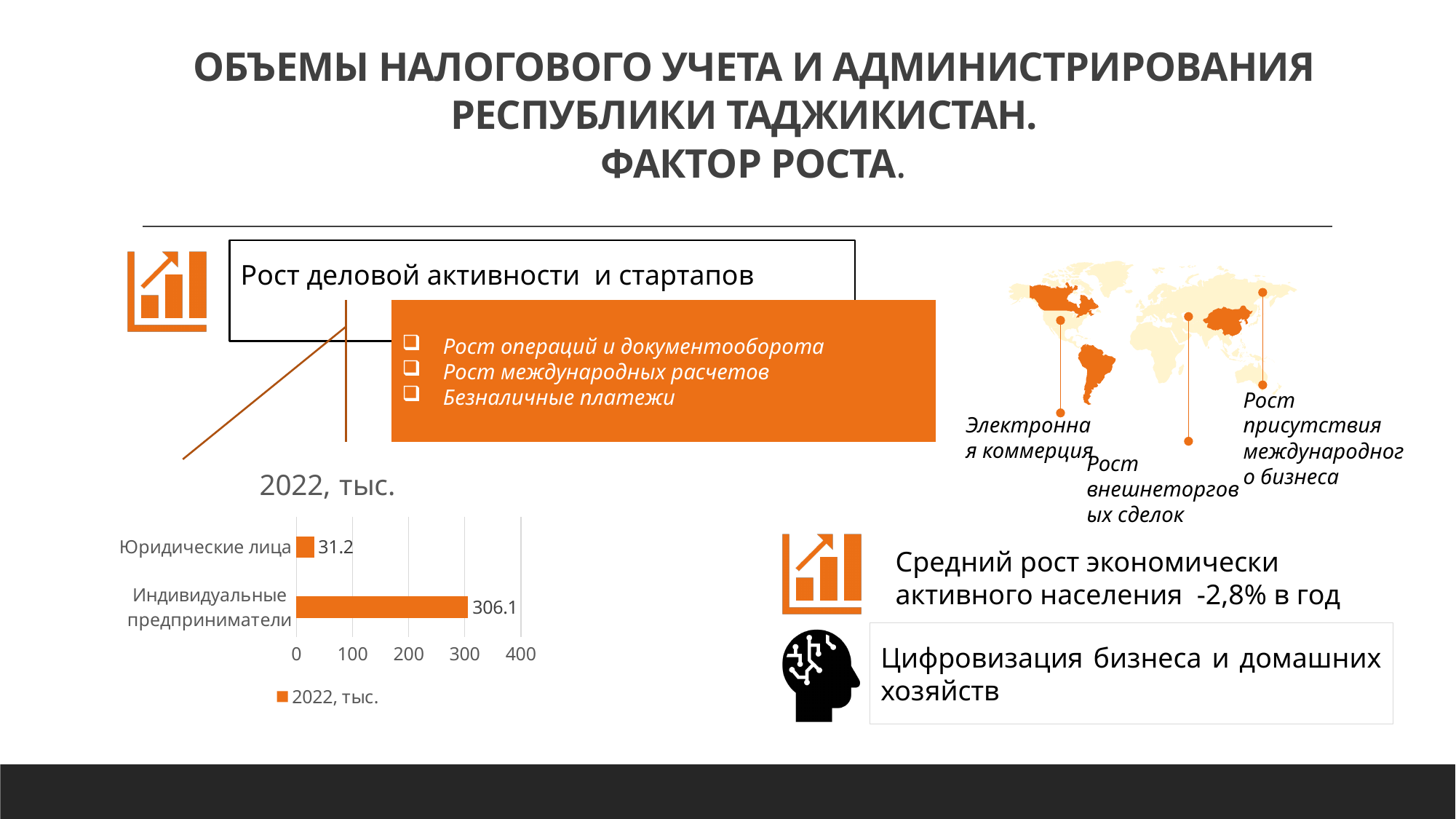
How many categories are shown in the chart titled 2022, тыс.? 2 How many series does the legend list in the chart titled 2022, тыс.? 1 What is the value for Индивидуальные предприниматели in the chart titled 2022, тыс.? 306.1 What is the difference between the values for Индивидуальные предприниматели and Юридические лица in the chart titled 2022, тыс.? 274.9 Which is larger in the chart titled 2022, тыс.: Юридические лица or Индивидуальные предприниматели? Индивидуальные предприниматели What is the value for Юридические лица in the chart titled 2022, тыс.? 31.2 What kind of chart is the chart titled 2022, тыс.? bar chart Is the value for Индивидуальные предприниматели greater or less than 300 in the chart titled 2022, тыс.? greater Which category has the highest value in the chart titled 2022, тыс.? Индивидуальные предприниматели What is the legend entry in the chart titled 2022, тыс.? 2022, тыс. Which category has the lowest value in the chart titled 2022, тыс.? Юридические лица Is the value for Юридические лица greater or less than 100 in the chart titled 2022, тыс.? less